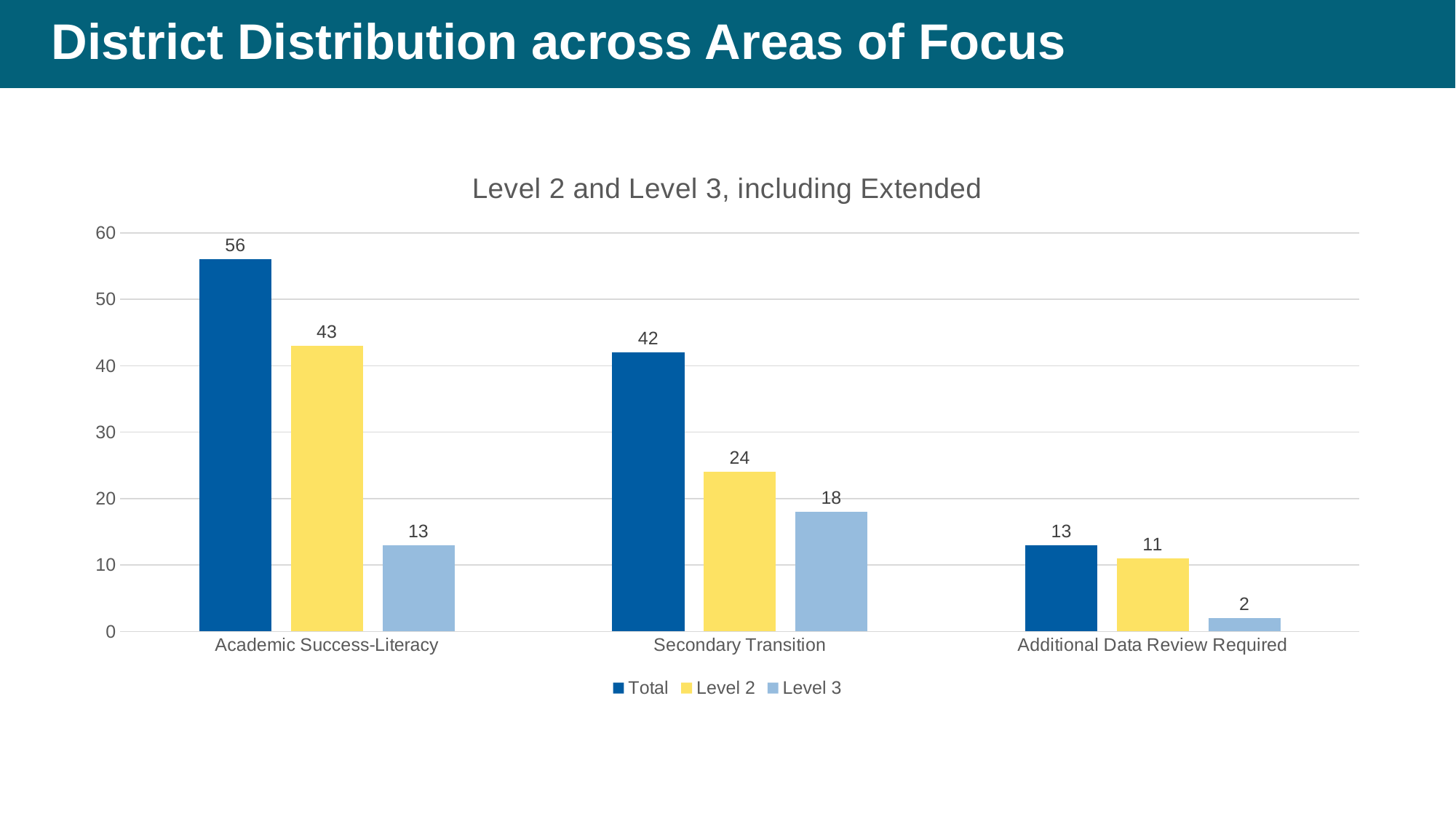
How many categories are shown on the x axis? 3 Which category has the lowest Level 3 value? Additional Data Review Required Which is larger: the Level 3 value for Secondary Transition or the Level 3 value for Academic Success-Literacy? Secondary Transition What is the difference between the Level 2 values for Academic Success-Literacy and Secondary Transition? 19 What is the Level 3 value for Additional Data Review Required? 2 What is the title of the chart? Level 2 and Level 3, including Extended What is the Level 2 value for Secondary Transition? 24 Which category has the highest Total value? Academic Success-Literacy How many series does the legend list? 3 What is the Total value for Academic Success-Literacy? 56 What kind of chart is shown on the slide? Bar chart Do the Total values rise or fall from left to right across the categories? Fall